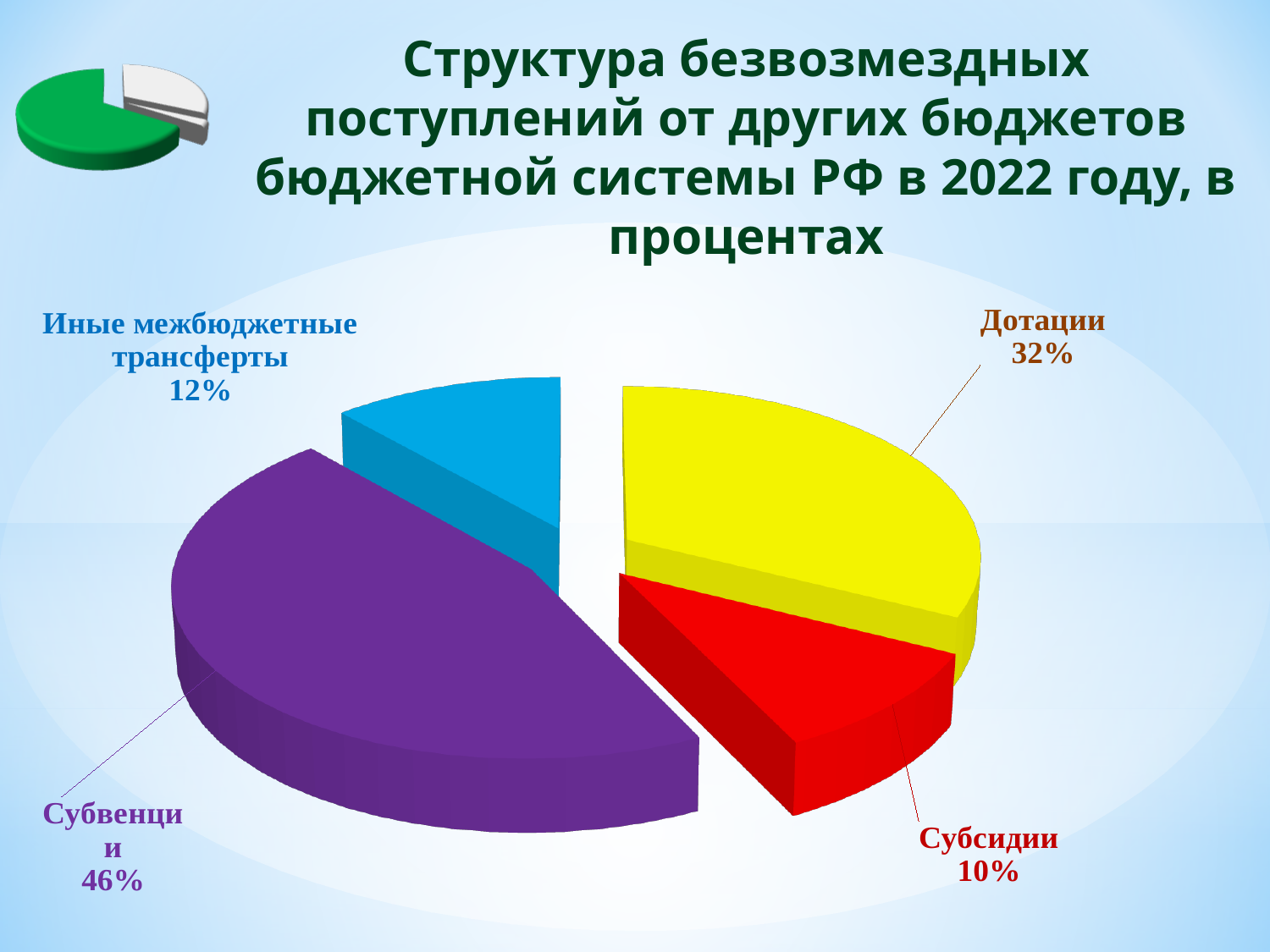
What kind of chart is shown on the slide? pie chart Which is larger, the share of Дотации or the share of Иные межбюджетные трансферты? Дотации What colour is the slice for Дотации? yellow What share does Иные межбюджетные трансферты have in the pie chart? 12% Which category has the largest share in the pie chart? Субвенции Which category has the smallest share in the pie chart? Субсидии What share does Субсидии have in the pie chart? 10% What share does Субвенции have in the pie chart? 46% What colour is the slice for Субвенции? purple How many slices does the pie chart have? 4 What share does Дотации have in the pie chart? 32% What is the difference in percentage points between Субвенции and Дотации? 14